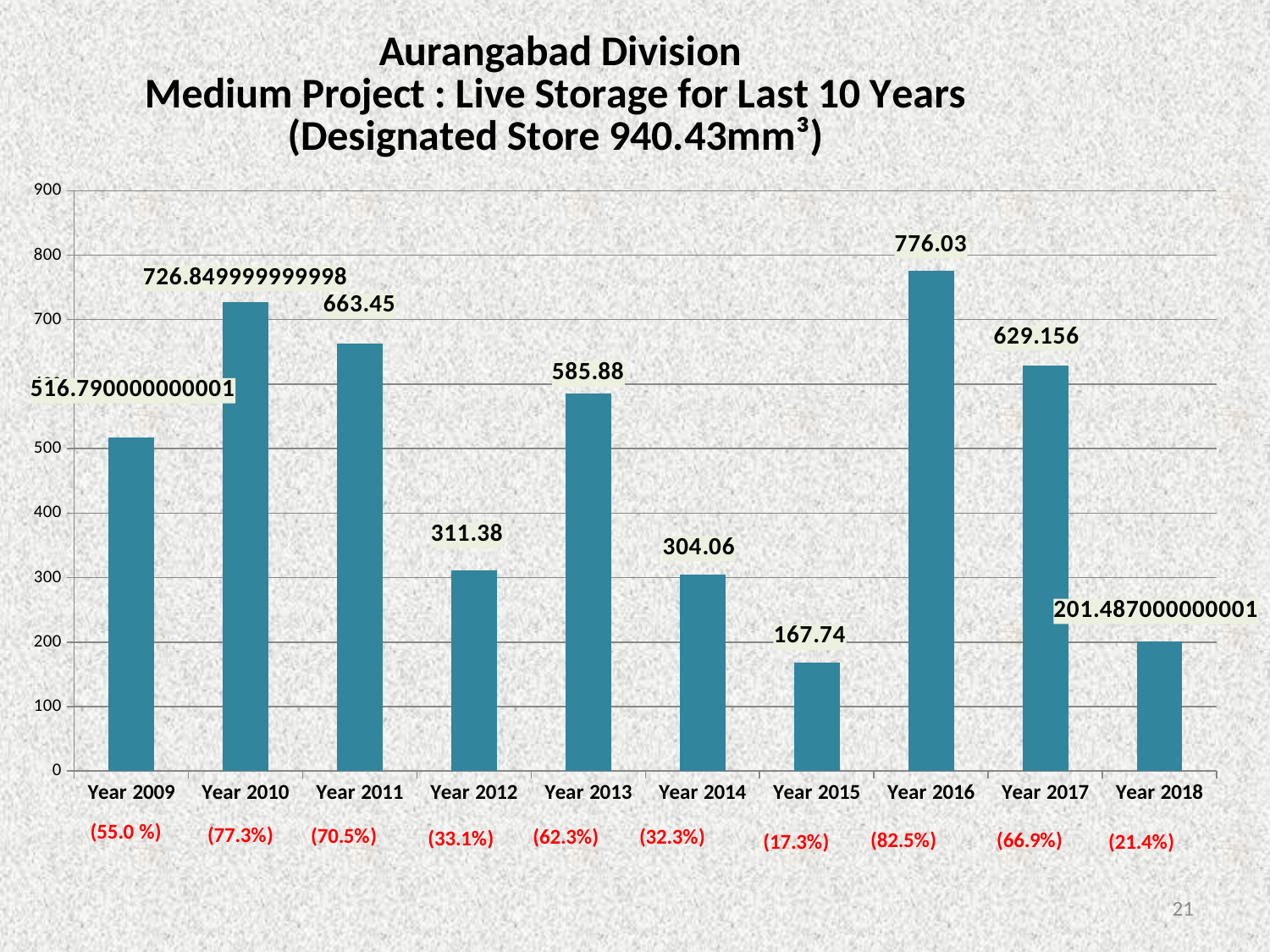
How many years (bars) are shown in the chart? 10 What is the live storage value shown for Year 2016? 776.03 What type of chart is shown on the slide? Bar chart What value is labelled on the bar for Year 2011? 663.45 What is the live storage value shown for Year 2015? 167.74 What is the difference between the values for Year 2011 and Year 2013? 77.57 Which year has the highest live storage value? Year 2016 What is the difference between the highest value (Year 2016) and the lowest value (Year 2015)? 608.29 Which year has the lowest live storage value? Year 2015 What value is labelled on the bar for Year 2017? 629.156 What percentage is shown in red below Year 2016? (82.5%) Which year has the larger value, Year 2012 or Year 2014? Year 2012